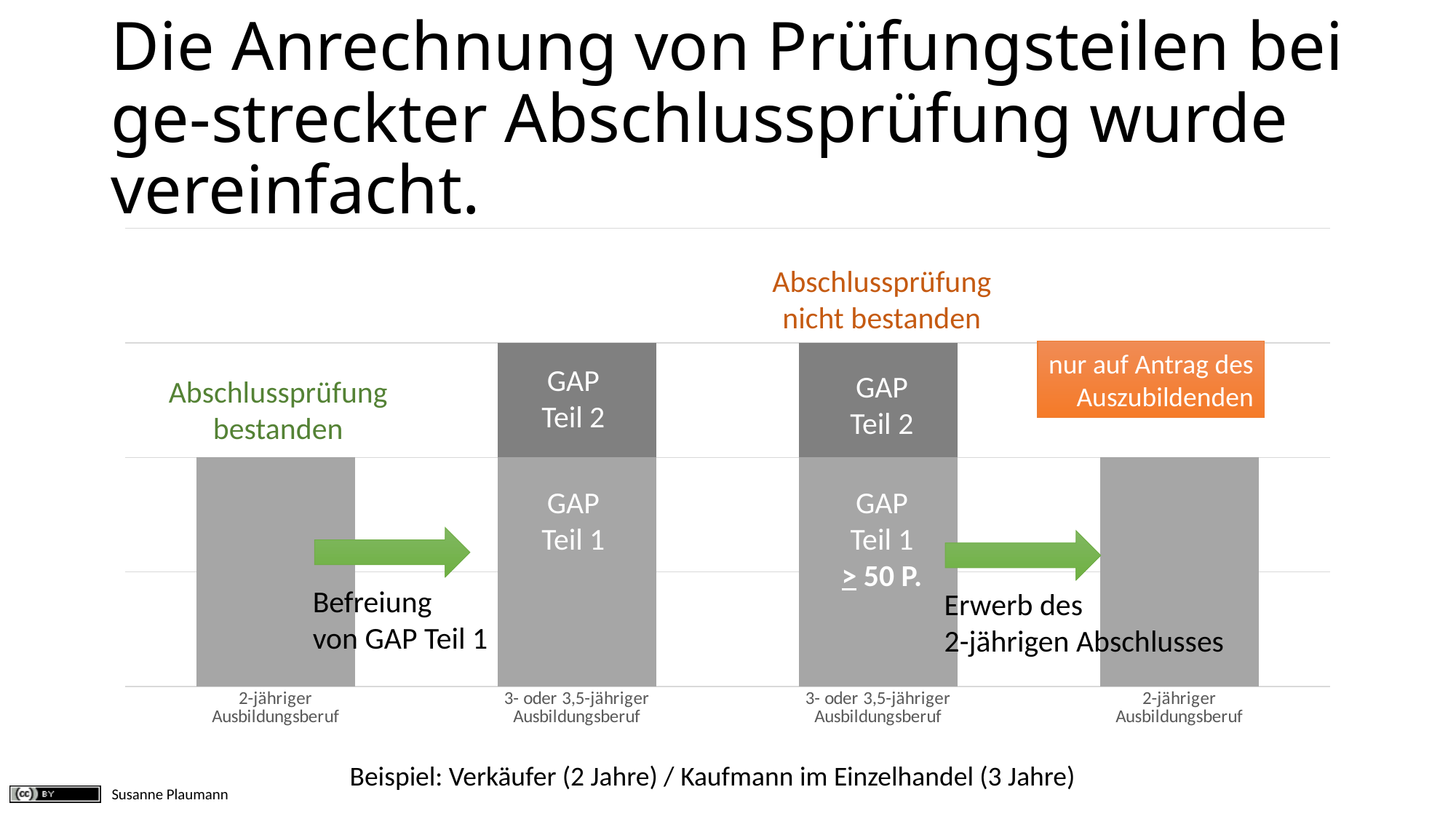
What text is shown in the orange box at the top right of the chart? nur auf Antrag des Auszubildenden What is the category label under the leftmost bar? 2-jähriger Ausbildungsberuf How many segments make up each of the two stacked bars for the 3- oder 3,5-jähriger Ausbildungsberuf? 2 Which bars are the shortest in the chart? the two bars for 2-jähriger Ausbildungsberuf What is the category label under the second bar from the left? 3- oder 3,5-jähriger Ausbildungsberuf Which is taller: the bar for the 2-jähriger Ausbildungsberuf on the left or the bar for the 3- oder 3,5-jähriger Ausbildungsberuf next to it? 3- oder 3,5-jähriger Ausbildungsberuf What kind of chart is shown on the slide? bar chart What is the category label under the rightmost bar? 2-jähriger Ausbildungsberuf What are the two segments of the stacked bars labelled? GAP Teil 1 and GAP Teil 2 How many bars are shown in the chart? 4 What point threshold is printed in the GAP Teil 1 segment of the third bar? ≥ 50 P.